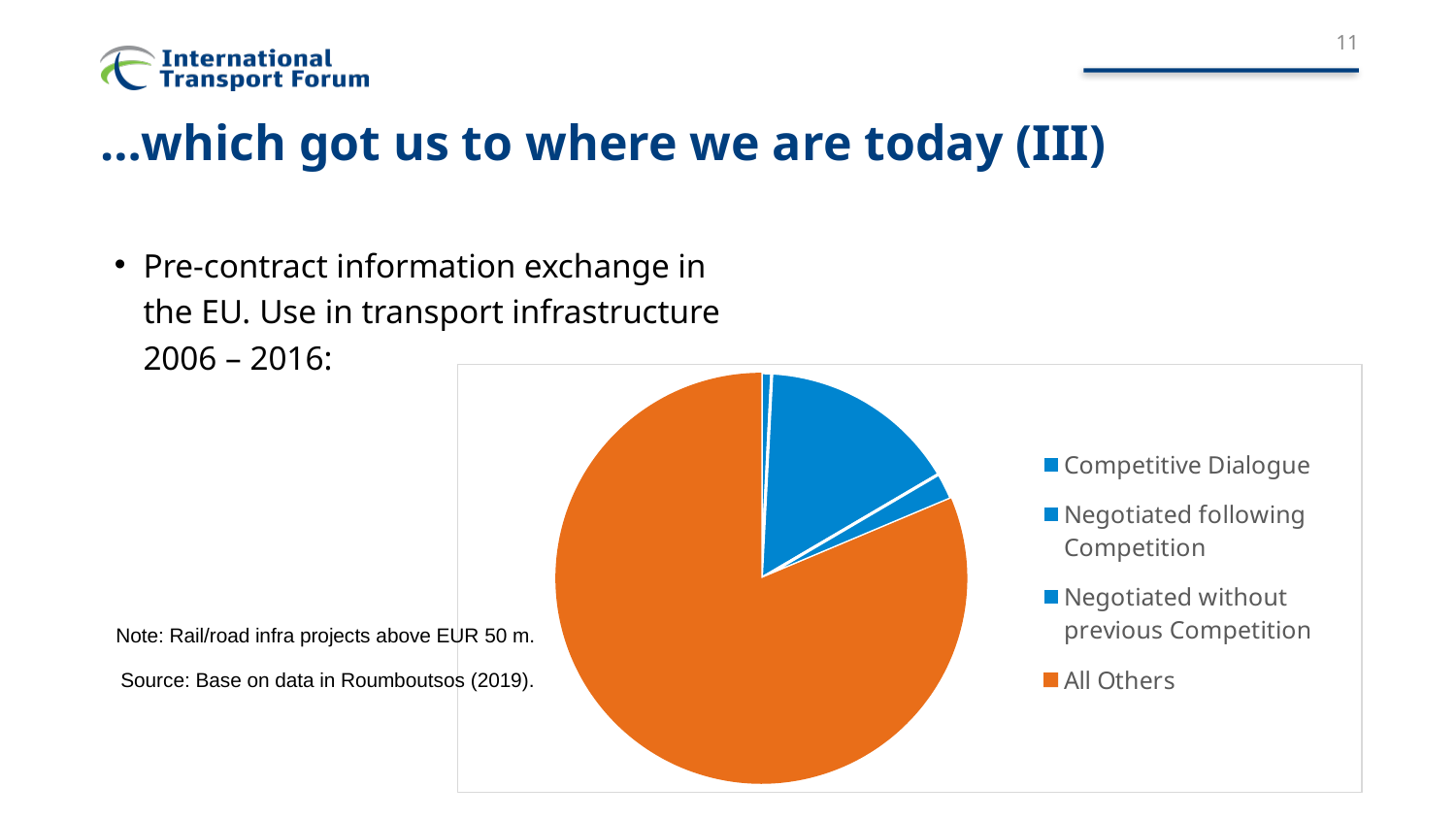
Which is larger in the pie chart: All Others or Negotiated following Competition? All Others Which is larger in the pie chart: All Others or Competitive Dialogue? All Others How many entries does the legend of the pie chart list? 4 Which category has the largest slice in the pie chart? All Others What colour is the All Others slice in the pie chart? Orange What are the four legend entries of the pie chart? Competitive Dialogue, Negotiated following Competition, Negotiated without previous Competition, All Others How many slices does the pie chart have? 4 What kind of chart is shown on the slide? Pie chart